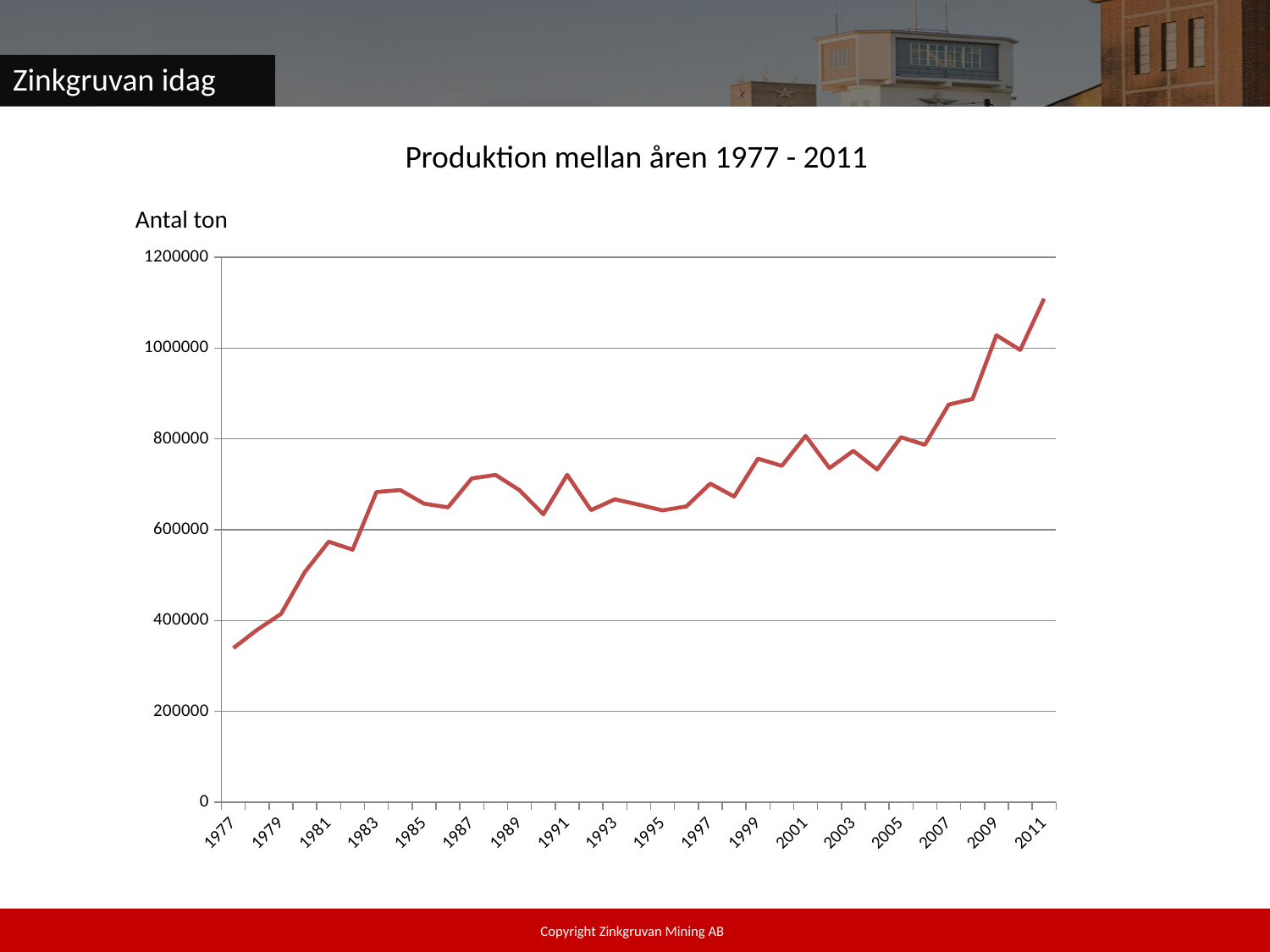
What kind of chart is shown on the slide? line chart Is the value for 1981 greater or less than 600000? less Is the value for 1977 greater or less than 400000? less In which year is production lowest? 1977 Is the value for 2007 greater or less than 800000? greater In which year is production highest? 2011 Overall, does production rise or fall from 1977 to 2011? rise What is the title of the chart? Produktion mellan åren 1977 - 2011 How many years are labeled on the x axis? 18 Which year has the higher production, 1983 or 1981? 1983 What is the label on the vertical axis of the chart? Antal ton